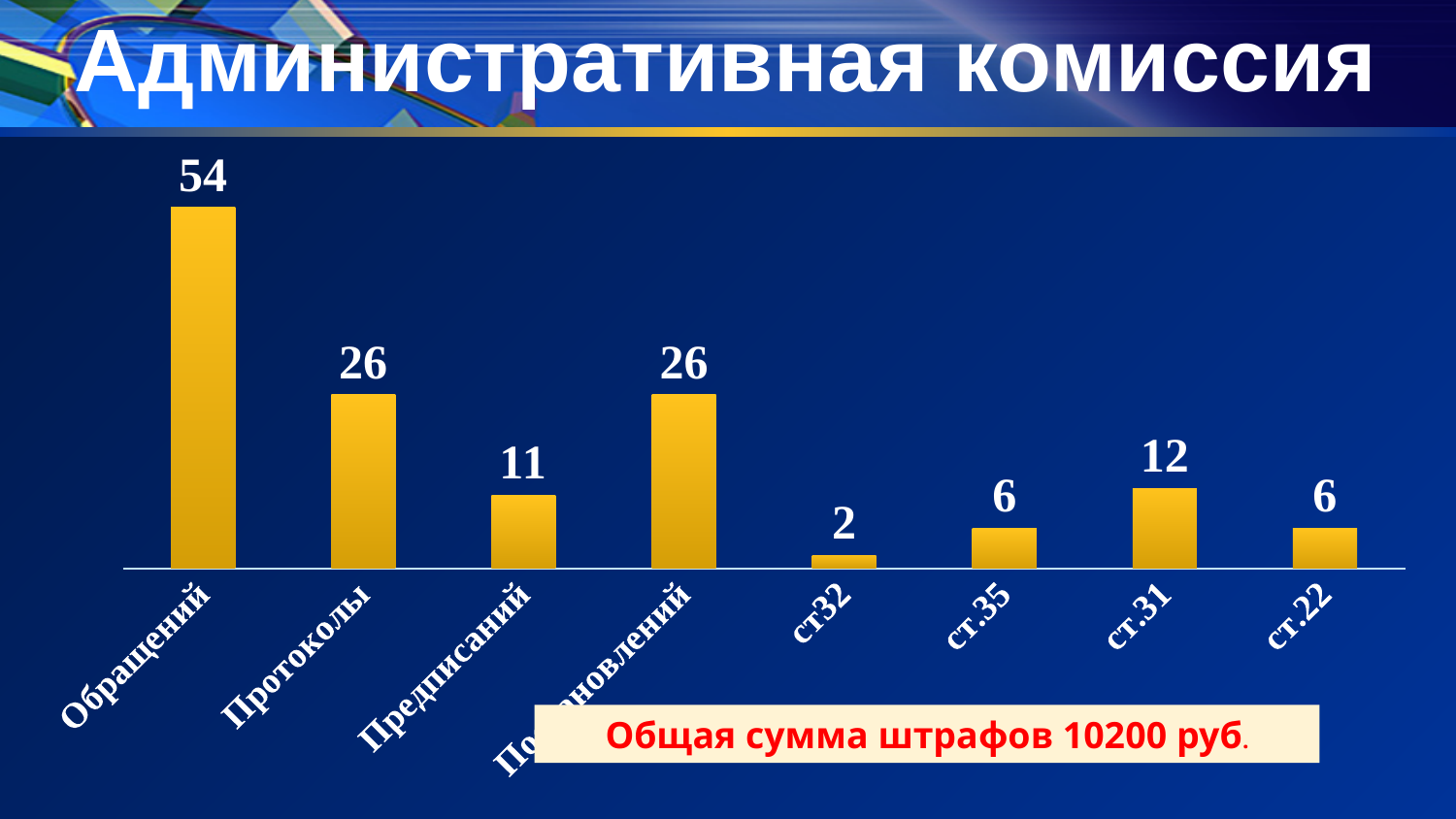
What is the value for Протоколы? 26 Which category has the lowest value? ст32 What is the value for ст.31? 12 What type of chart is shown on the slide? bar chart Which category has the highest value? Обращений What is the value for Обращений? 54 What is the value for Предписаний? 11 Which is larger, the value for ст.31 or the value for ст.35? ст.31 What is the value for ст32? 2 What is the difference between the values for Обращений and Протоколы? 28 How many bars are shown in the chart? 8 What total sum of fines is stated in the text box below the chart? 10200 руб.